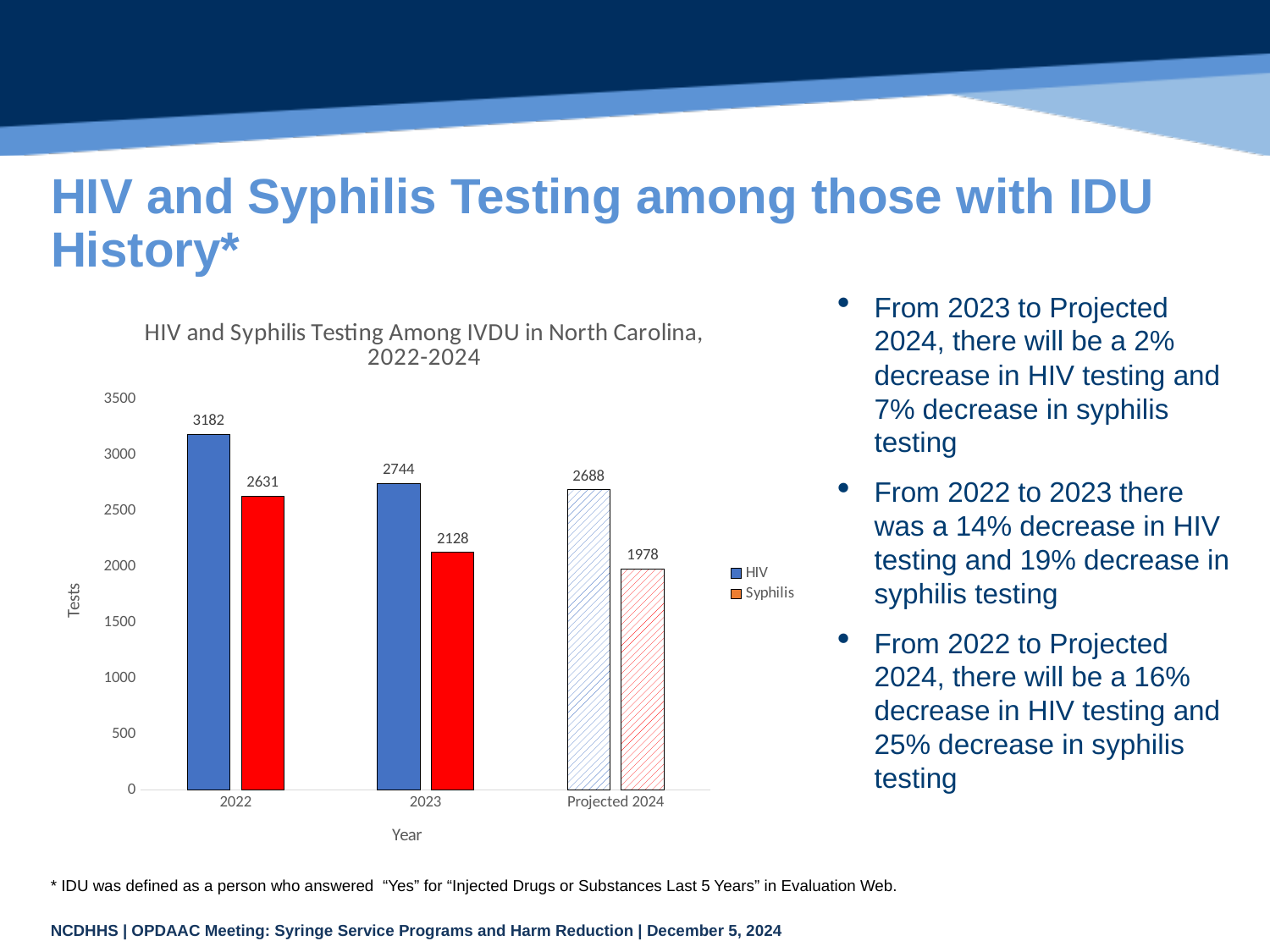
What kind of chart is shown on the slide? Bar chart How many year categories are shown on the x axis? 3 Which is larger, the Syphilis value for 2022 or the HIV value for 2023? HIV value for 2023 Which year has the highest HIV testing value? 2022 Which year has the lowest Syphilis testing value? Projected 2024 What is the Syphilis testing value for 2023? 2128 What is the Syphilis testing value for Projected 2024? 1978 Do the Syphilis testing values rise or fall from 2022 to Projected 2024? Fall What is the difference between the HIV and Syphilis testing values in 2022? 551 What is the difference between the HIV testing values for 2023 and Projected 2024? 56 What is the HIV testing value for 2022? 3182 How many series does the legend list? 2